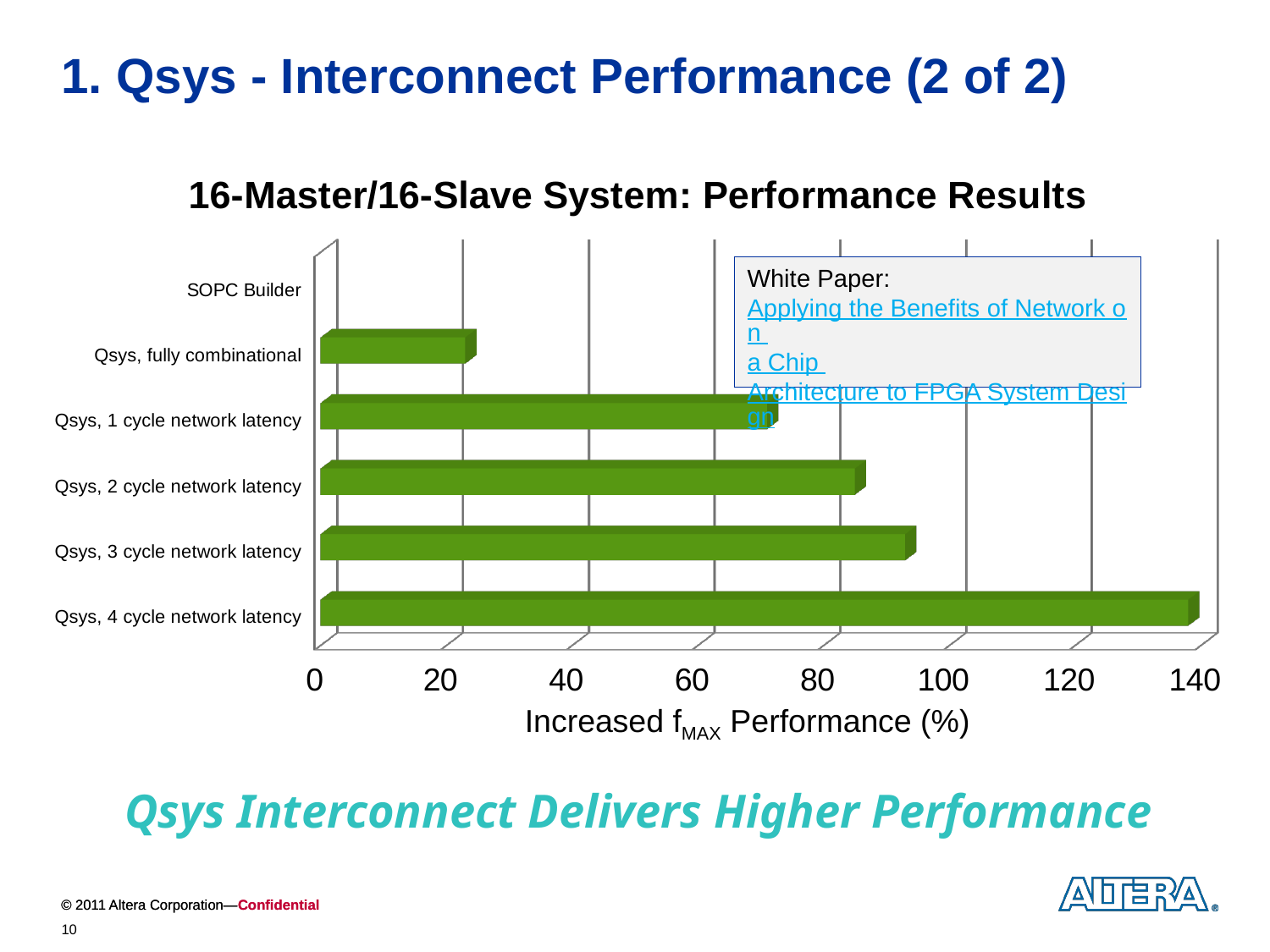
What kind of chart is shown on the slide? bar chart Is the value for Qsys, 1 cycle network latency greater or less than 60? greater Is the value for Qsys, 2 cycle network latency greater or less than 80? greater What is the title of the chart? 16-Master/16-Slave System: Performance Results Which category has the highest increased fMAX performance? Qsys, 4 cycle network latency Which is larger, the value for Qsys, 4 cycle network latency or Qsys, 1 cycle network latency? Qsys, 4 cycle network latency What is the label of the horizontal axis? Increased fMAX Performance (%) How many categories are plotted on the chart? 6 Which category has the lowest increased fMAX performance? SOPC Builder Is the value for Qsys, 3 cycle network latency greater or less than 100? less